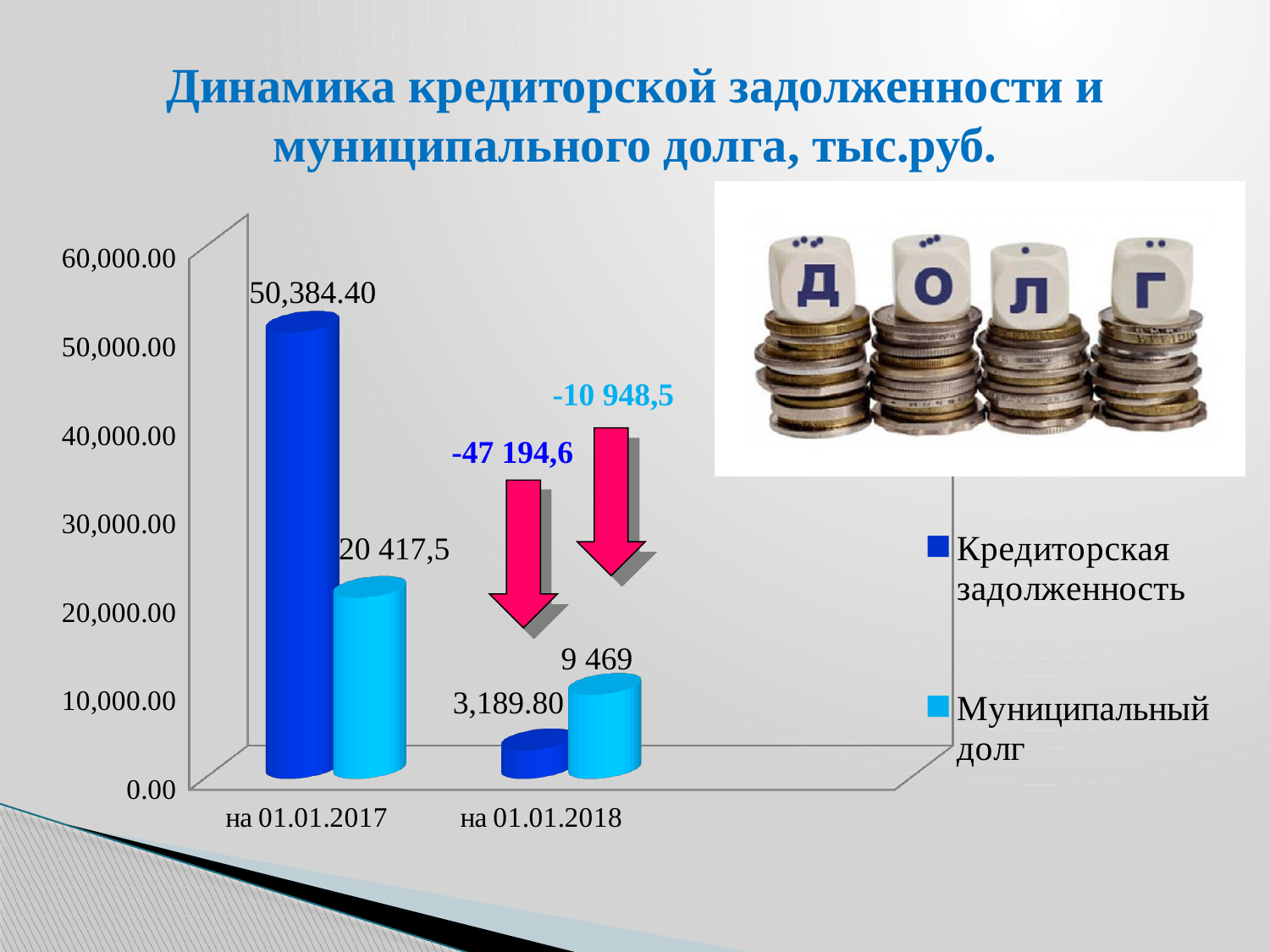
What is the value of Кредиторская задолженность на 01.01.2018? 3,189.80 What is the value of Кредиторская задолженность на 01.01.2017? 50,384.40 What kind of chart is shown on the slide? bar chart Which series has the highest value on the chart? Кредиторская задолженность (на 01.01.2017) Does Кредиторская задолженность rise or fall from 01.01.2017 to 01.01.2018? fall What is the value of Муниципальный долг на 01.01.2017? 20 417,5 What is the value of Муниципальный долг на 01.01.2018? 9 469 Which bar has the lowest value on the chart? Кредиторская задолженность на 01.01.2018 На 01.01.2018, which is larger: Кредиторская задолженность or Муниципальный долг? Муниципальный долг Is the value of Кредиторская задолженность на 01.01.2017 greater or less than 50,000.00? greater How many categories are shown on the x axis? 2 How many series does the legend list? 2